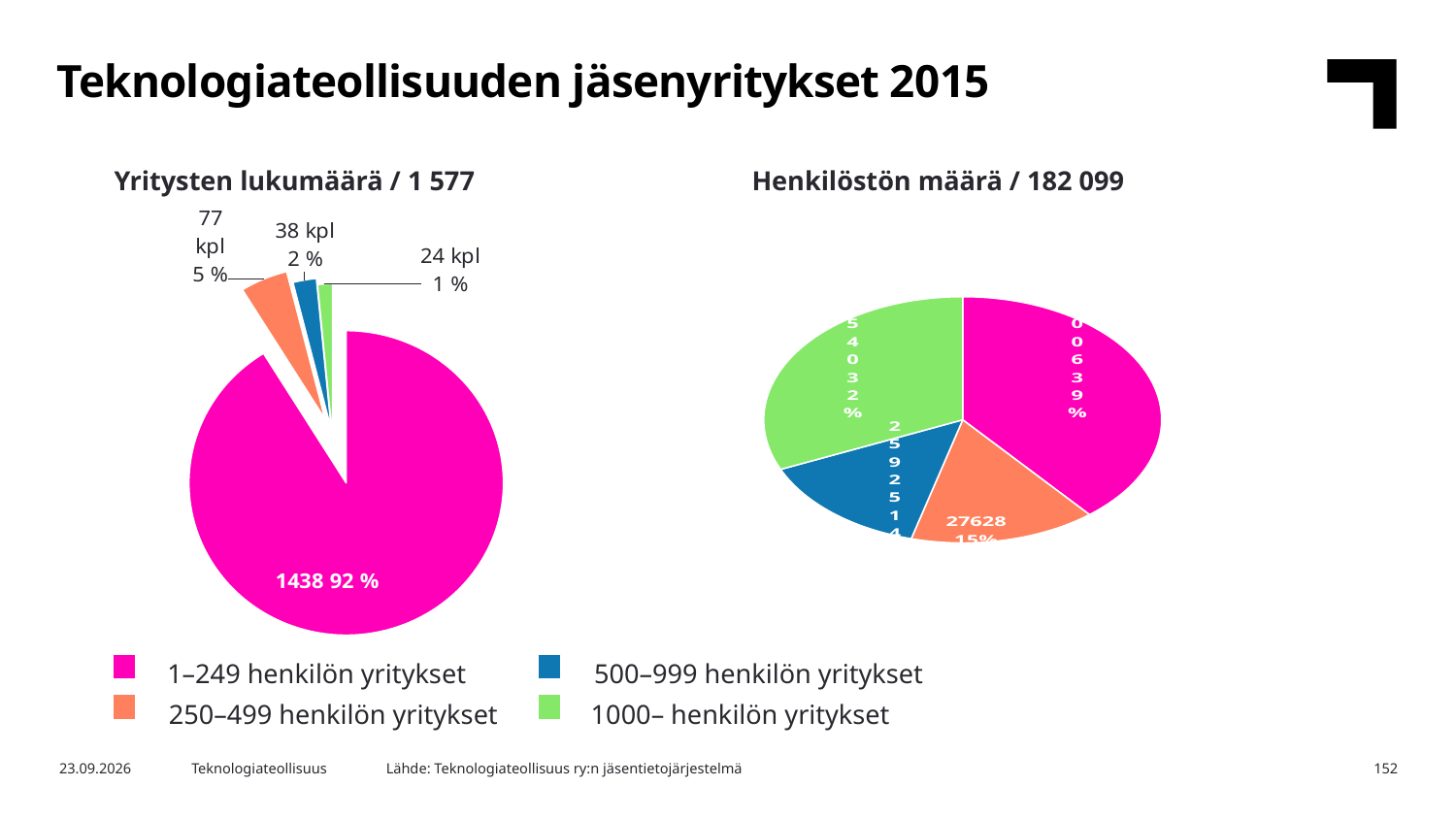
How many categories does the legend list? 4 In the left chart 'Yritysten lukumäärä / 1 577', which is larger: 250–499 henkilön yritykset or 500–999 henkilön yritykset? 250–499 henkilön yritykset In the left chart 'Yritysten lukumäärä / 1 577', what share of the pie is the 500–999 henkilön yritykset slice? 2 % In the right chart 'Henkilöstön määrä / 182 099', which category has the largest slice? 1–249 henkilön yritykset In the left chart 'Yritysten lukumäärä / 1 577', what is the value for 250–499 henkilön yritykset? 77 kpl In the left chart 'Yritysten lukumäärä / 1 577', which category has the largest slice? 1–249 henkilön yritykset What kind of chart is the left chart titled 'Yritysten lukumäärä / 1 577'? pie chart In the left chart 'Yritysten lukumäärä / 1 577', how many companies are in the 1–249 henkilön yritykset category? 1438 In the left chart 'Yritysten lukumäärä / 1 577', what is the difference between the number of 250–499 henkilön yritykset and 500–999 henkilön yritykset? 39 In the left chart 'Yritysten lukumäärä / 1 577', which category has the smallest slice? 1000– henkilön yritykset In the left chart 'Yritysten lukumäärä / 1 577', what is the value for 1000– henkilön yritykset? 24 kpl In the left chart 'Yritysten lukumäärä / 1 577', what share of the pie is the 1–249 henkilön yritykset slice? 92 %